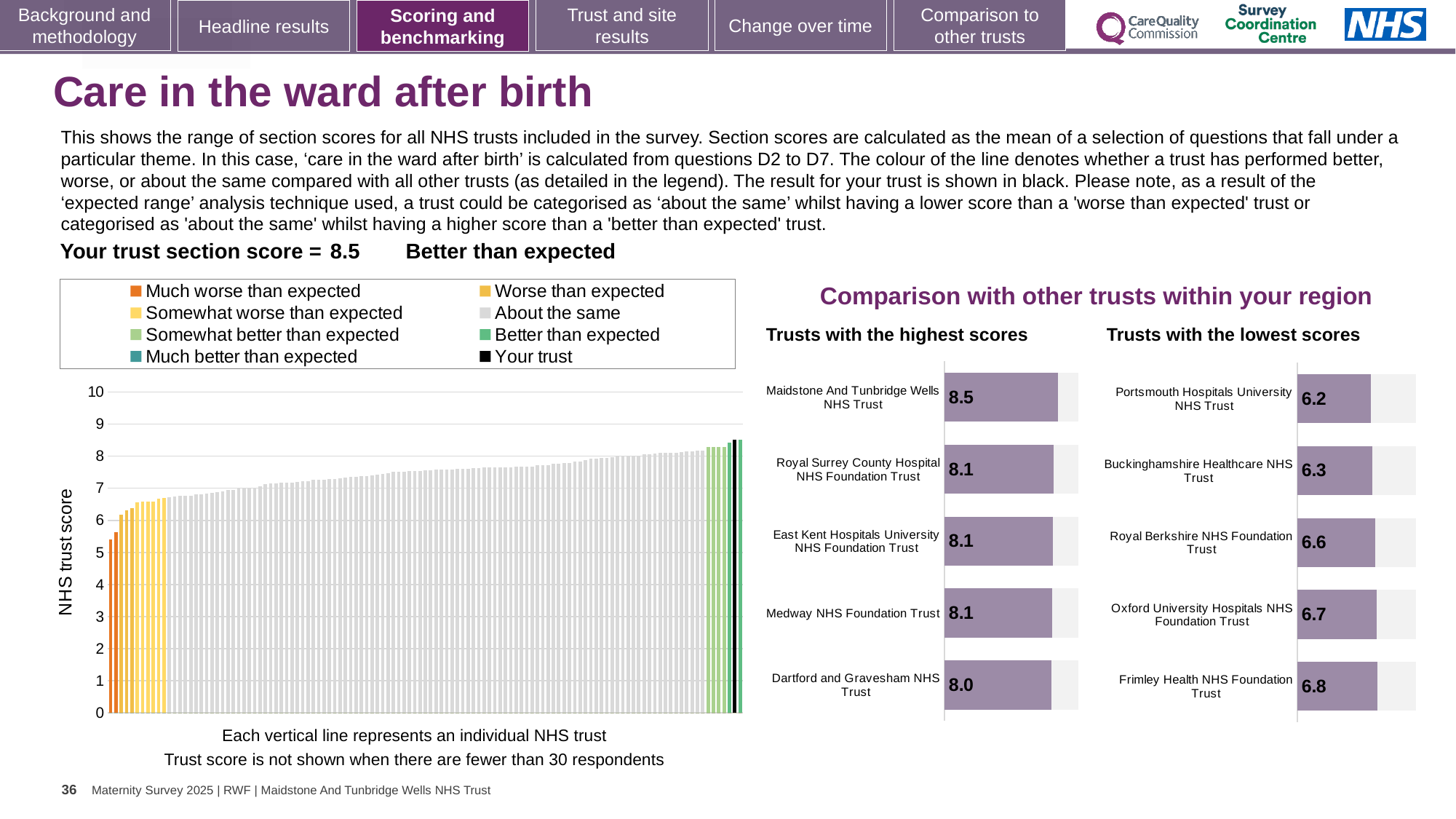
In the 'Trusts with the lowest scores' chart, what is the score for Portsmouth Hospitals University NHS Trust? 6.2 How many trusts are listed in the 'Trusts with the highest scores' chart? 5 In the large chart on the left showing all NHS trusts, is the value for the lowest-scoring trust (the leftmost bar) greater or less than 6? less In the 'Trusts with the highest scores' chart, what is the score for Dartford and Gravesham NHS Trust? 8.0 In the 'Trusts with the highest scores' chart, what is the score for Maidstone And Tunbridge Wells NHS Trust? 8.5 In the 'Trusts with the lowest scores' chart, which trust has the lowest score? Portsmouth Hospitals University NHS Trust What type of chart is the large chart on the left showing all NHS trust scores? Bar chart In the 'Trusts with the highest scores' chart, what is the difference between the scores for Maidstone And Tunbridge Wells NHS Trust and Dartford and Gravesham NHS Trust? 0.5 In the 'Trusts with the highest scores' chart, which trust has the highest score? Maidstone And Tunbridge Wells NHS Trust In the 'Trusts with the lowest scores' chart, what is the score for Frimley Health NHS Foundation Trust? 6.8 In the 'Trusts with the lowest scores' chart, what is the difference between the scores for Frimley Health NHS Foundation Trust and Portsmouth Hospitals University NHS Trust? 0.6 In the 'Trusts with the lowest scores' chart, which has the larger score: Buckinghamshire Healthcare NHS Trust or Oxford University Hospitals NHS Foundation Trust? Oxford University Hospitals NHS Foundation Trust